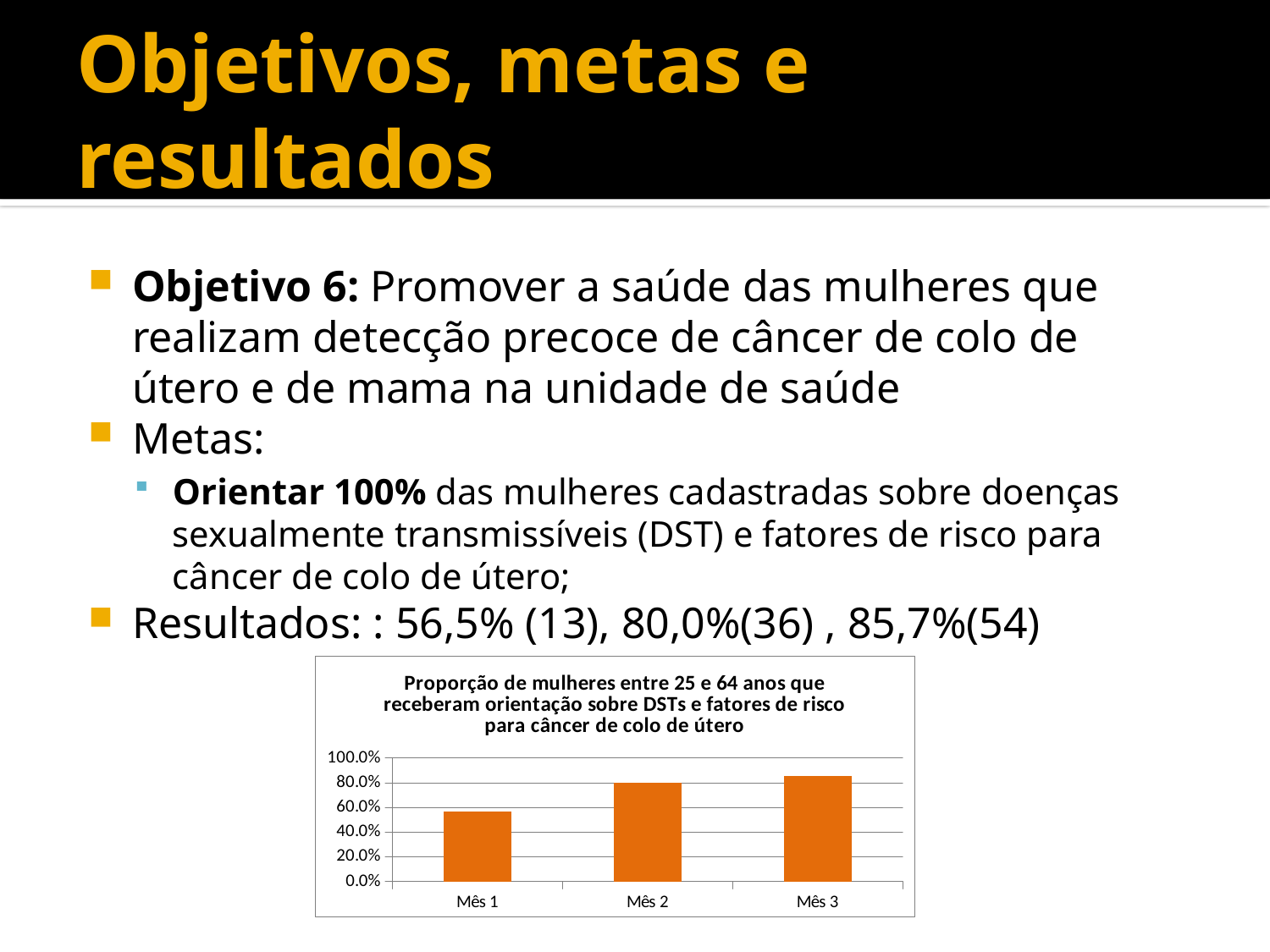
What kind of chart is shown on the slide? bar chart Which is larger, the value for Mês 1 or the value for Mês 2? Mês 2 Which month has the lowest proportion in the chart? Mês 1 What is the value for Mês 2 in the chart? 80.0% Do the values rise or fall from Mês 1 to Mês 3? rise Is the value for Mês 1 greater or less than 40.0%? greater What colour are the bars in the chart? orange Is the value for Mês 3 greater or less than 80.0%? greater Is the value for Mês 1 greater or less than 60.0%? less What is the title of the chart? Proporção de mulheres entre 25 e 64 anos que receberam orientação sobre DSTs e fatores de risco para câncer de colo de útero Which month has the highest proportion in the chart? Mês 3 How many months (categories) are plotted in the chart? 3